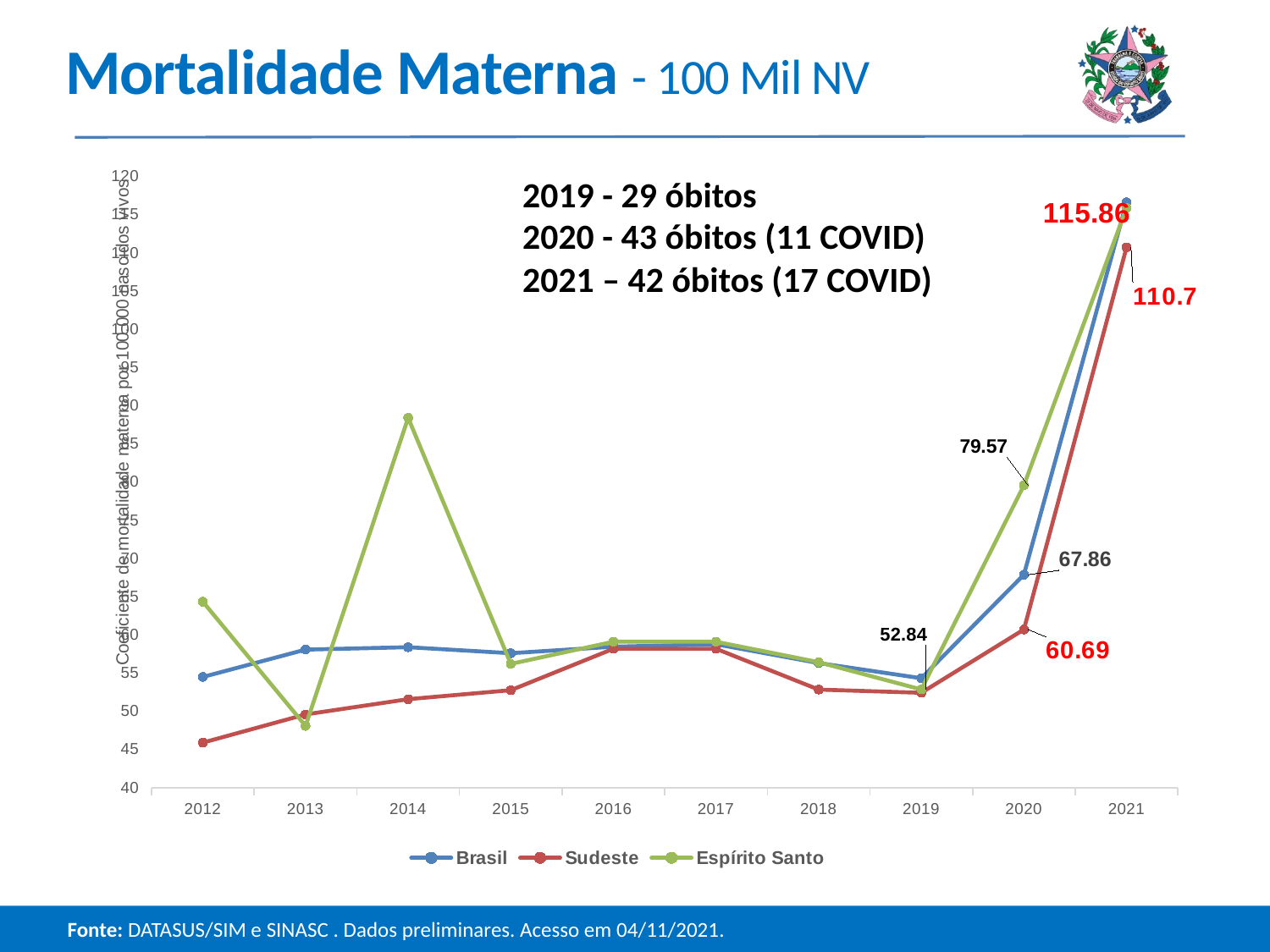
How many years are shown on the x axis? 10 What is the highest value labelled on the chart? 115.86 Which series are listed in the legend? Brasil, Sudeste, Espírito Santo What is the labelled value for Espírito Santo in 2020? 79.57 What kind of chart is shown on the slide? line chart Do the values for all three series rise or fall from 2019 to 2021? rise What is the difference between the labelled 2020 values for Espírito Santo (79.57) and Brasil (67.86)? 11.71 Is the value for Espírito Santo in 2014 greater or less than 80? greater In 2012, which is larger, the value for Brasil or the value for Sudeste? Brasil How many series does the legend list? 3 Is the value for Sudeste in 2012 greater or less than 50? less What is the labelled value for Brasil in 2020? 67.86